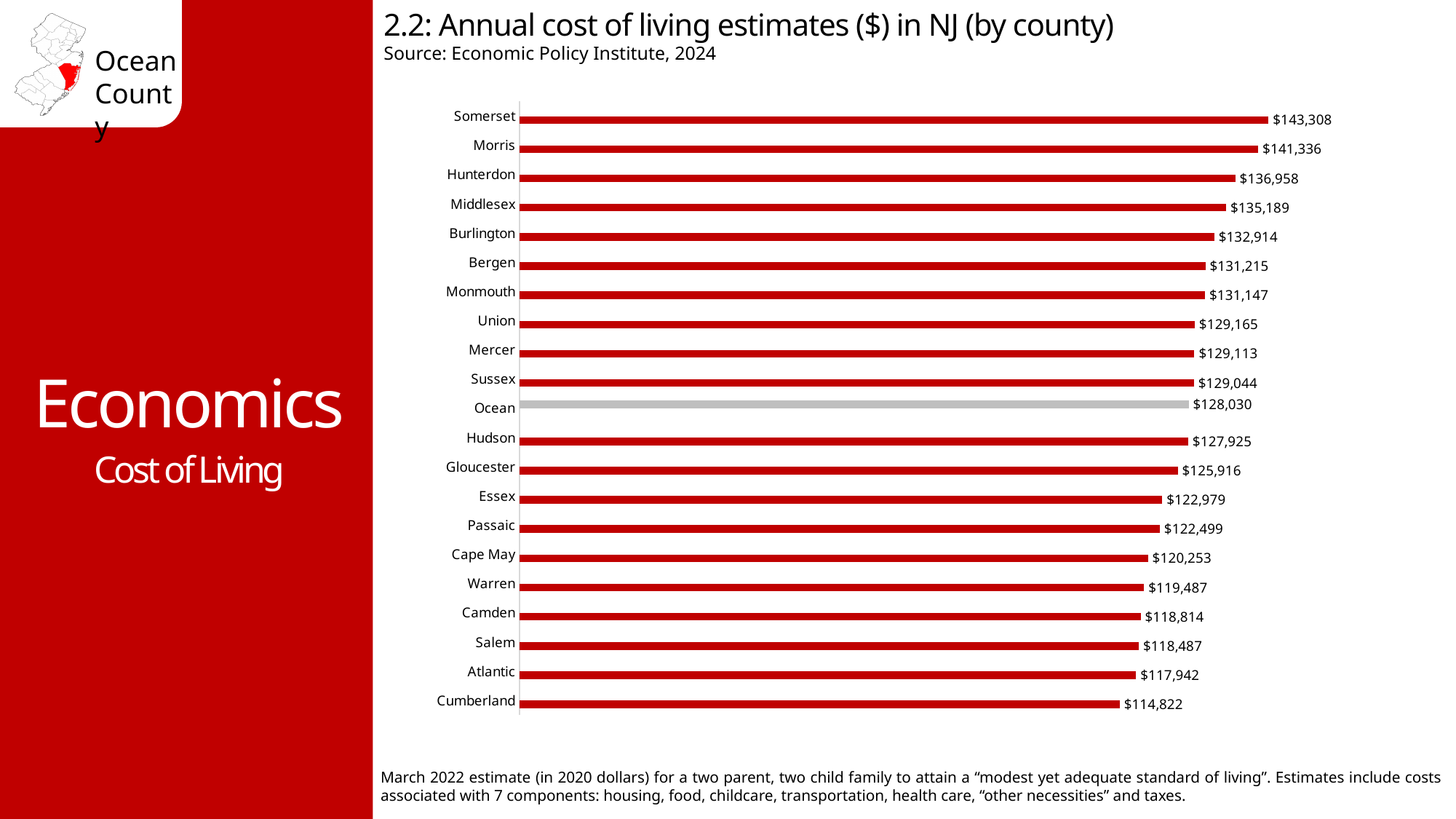
Which county has a higher cost of living estimate, Hunterdon or Middlesex? Hunterdon Which county has a higher cost of living estimate, Essex or Gloucester? Gloucester What is the difference between the cost of living estimates for Somerset and Cumberland counties? $28,486 Which county has the highest annual cost of living estimate? Somerset Which county has the lowest annual cost of living estimate? Cumberland What is the annual cost of living estimate for Bergen County? $131,215 Which county's bar is shown in gray rather than red? Ocean How many counties are shown in the chart? 21 What is the annual cost of living estimate for Ocean County? $128,030 What is the annual cost of living estimate for Cape May County? $120,253 What is the difference between the cost of living estimates for Somerset and Morris counties? $1,972 What type of chart is used to show the annual cost of living estimates? Bar chart